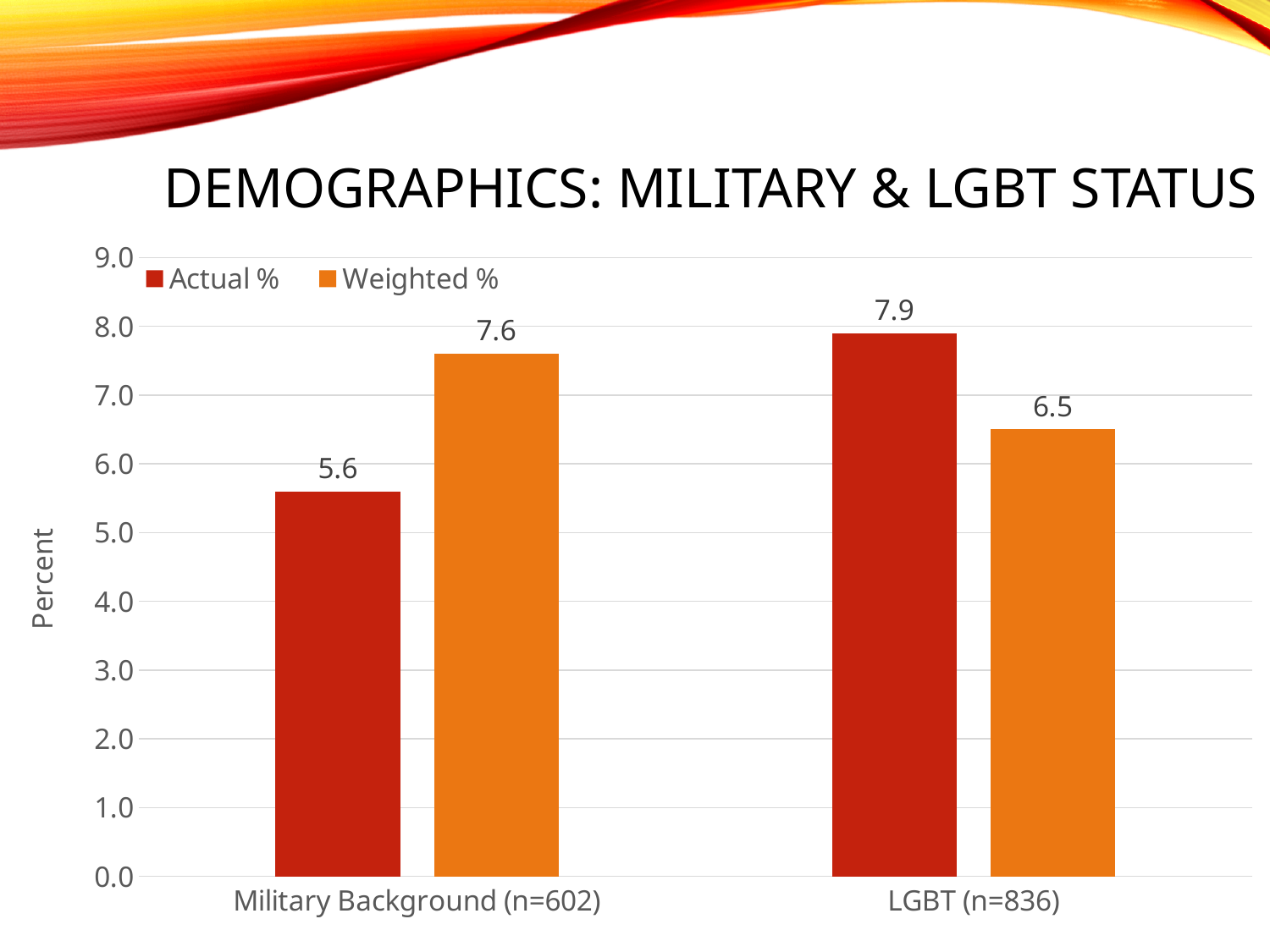
What kind of chart is shown on the slide? bar chart What is the Weighted % value for LGBT (n=836)? 6.5 What is the Actual % value for Military Background (n=602)? 5.6 Is the Actual % value for Military Background (n=602) greater or less than 6.0? less What is the difference between the Actual % and Weighted % values for LGBT (n=836)? 1.4 What is the difference between the Weighted % and Actual % values for Military Background (n=602)? 2.0 How many series does the legend list? 2 Which category has the lowest Weighted % value? LGBT (n=836) Which category has the highest Actual % value? LGBT (n=836) What is the Weighted % value for Military Background (n=602)? 7.6 Which is larger for LGBT (n=836): the Actual % or the Weighted % value? Actual % How many categories are shown on the x axis? 2